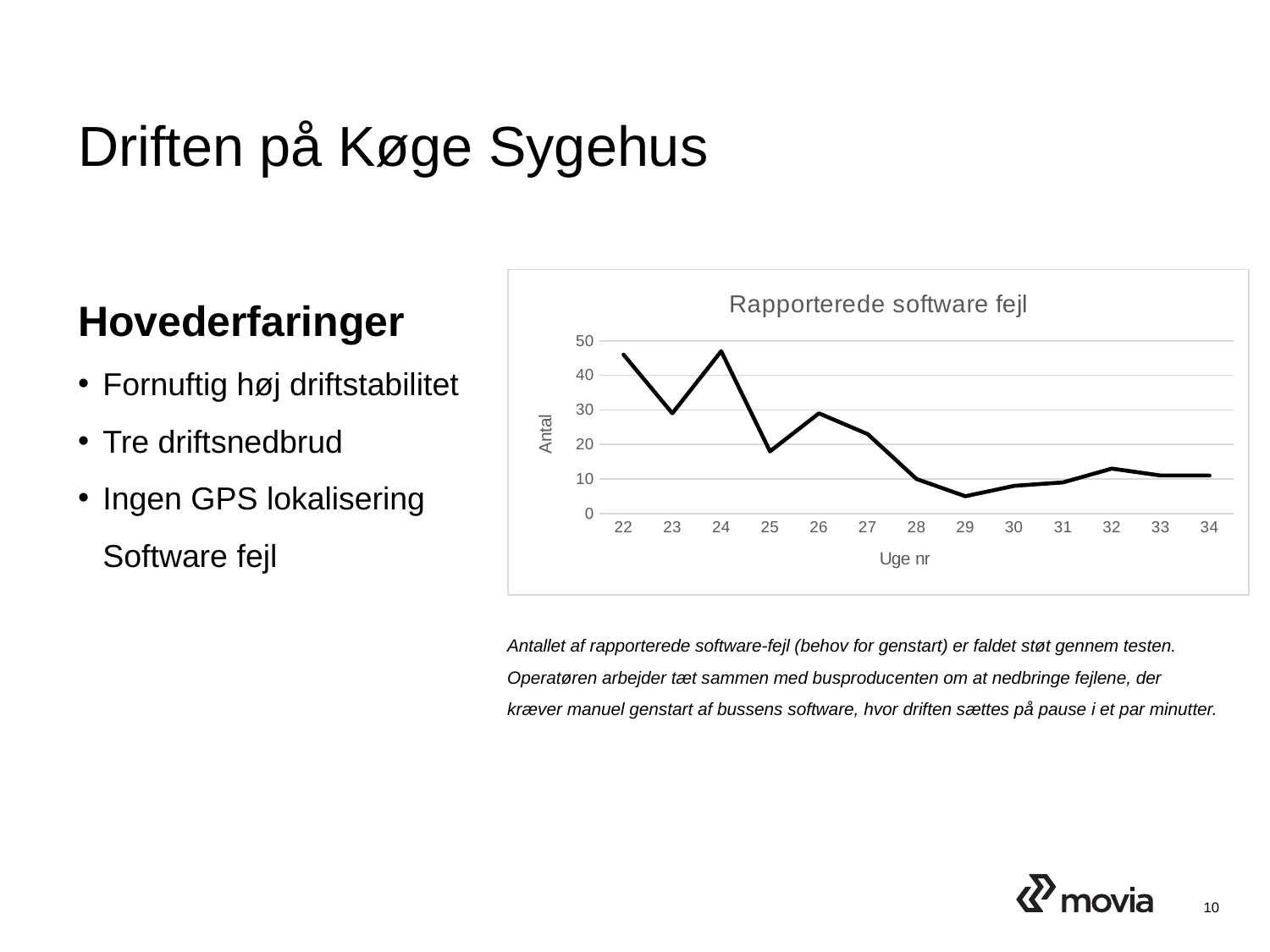
Which week has the larger value, week 24 or week 25? 24 What kind of chart is shown on the slide? line chart Is the value for week 22 greater or less than 40? greater Is the value for week 29 greater or less than 10? less What is the title of the chart? Rapporterede software fejl Is the value for week 25 greater or less than 20? less How many weeks are plotted on the x axis of the chart? 13 Which week has the larger value, week 23 or week 28? 23 Do the values generally rise or fall from week 22 to week 34? fall What is the label on the x axis of the chart? Uge nr Which week has the lowest number of reported software errors? 29